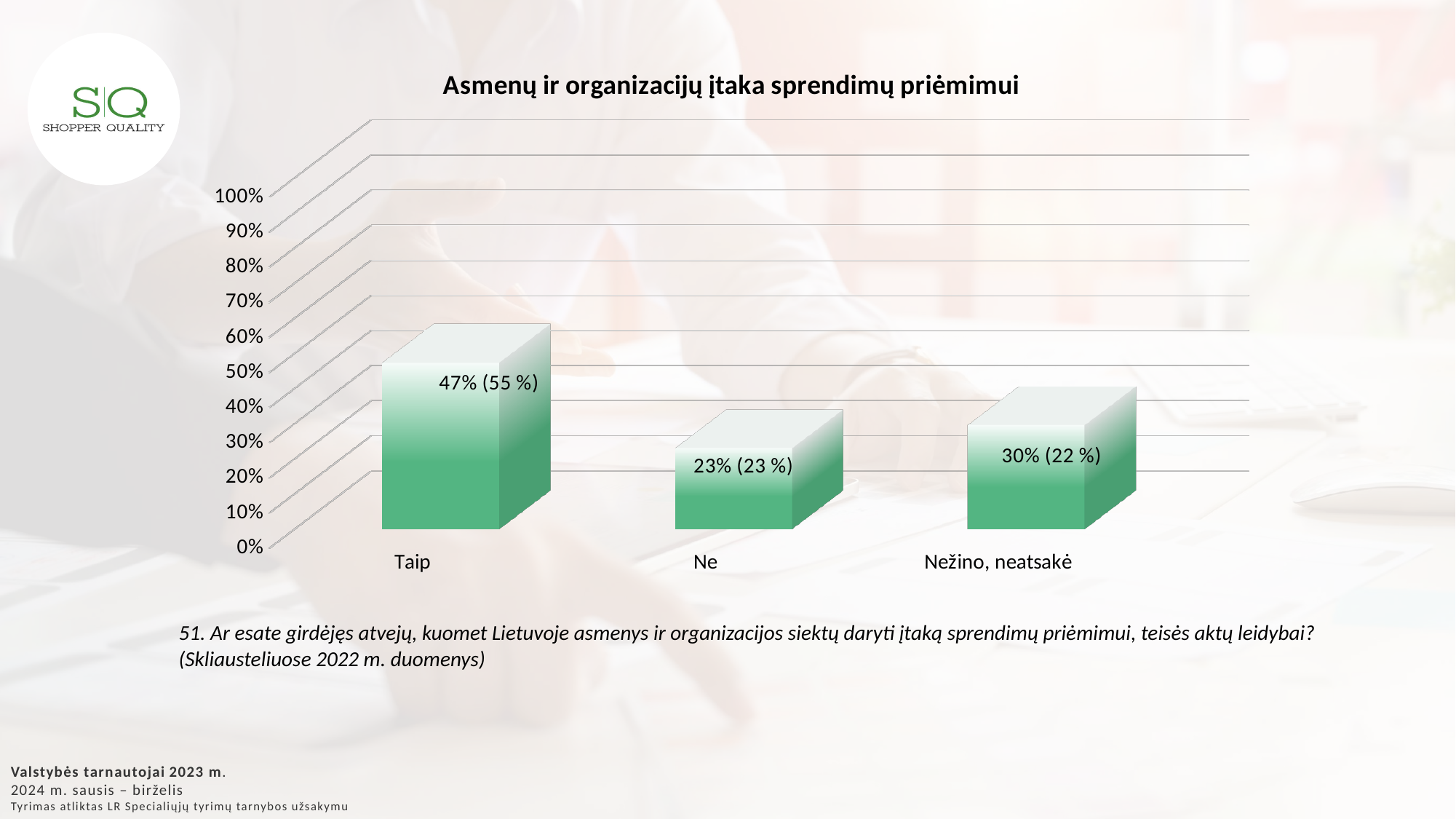
Is the value for "Taip" greater or less than 40%? greater Which category has the highest value? Taip What is the difference between the current values for "Taip" and "Ne"? 24% What is the value shown for "Nežino, neatsakė"? 30% (22 %) How many categories are shown on the x axis? 3 What kind of chart is shown on the slide? bar chart What is the value shown for "Ne"? 23% (23 %) Which is larger, the current value for "Ne" or for "Nežino, neatsakė"? Nežino, neatsakė What is the title of the chart? Asmenų ir organizacijų įtaka sprendimų priėmimui What is the value shown for "Taip"? 47% (55 %) What is the difference between the current values for "Nežino, neatsakė" and "Ne"? 7% Which category has the lowest value? Ne